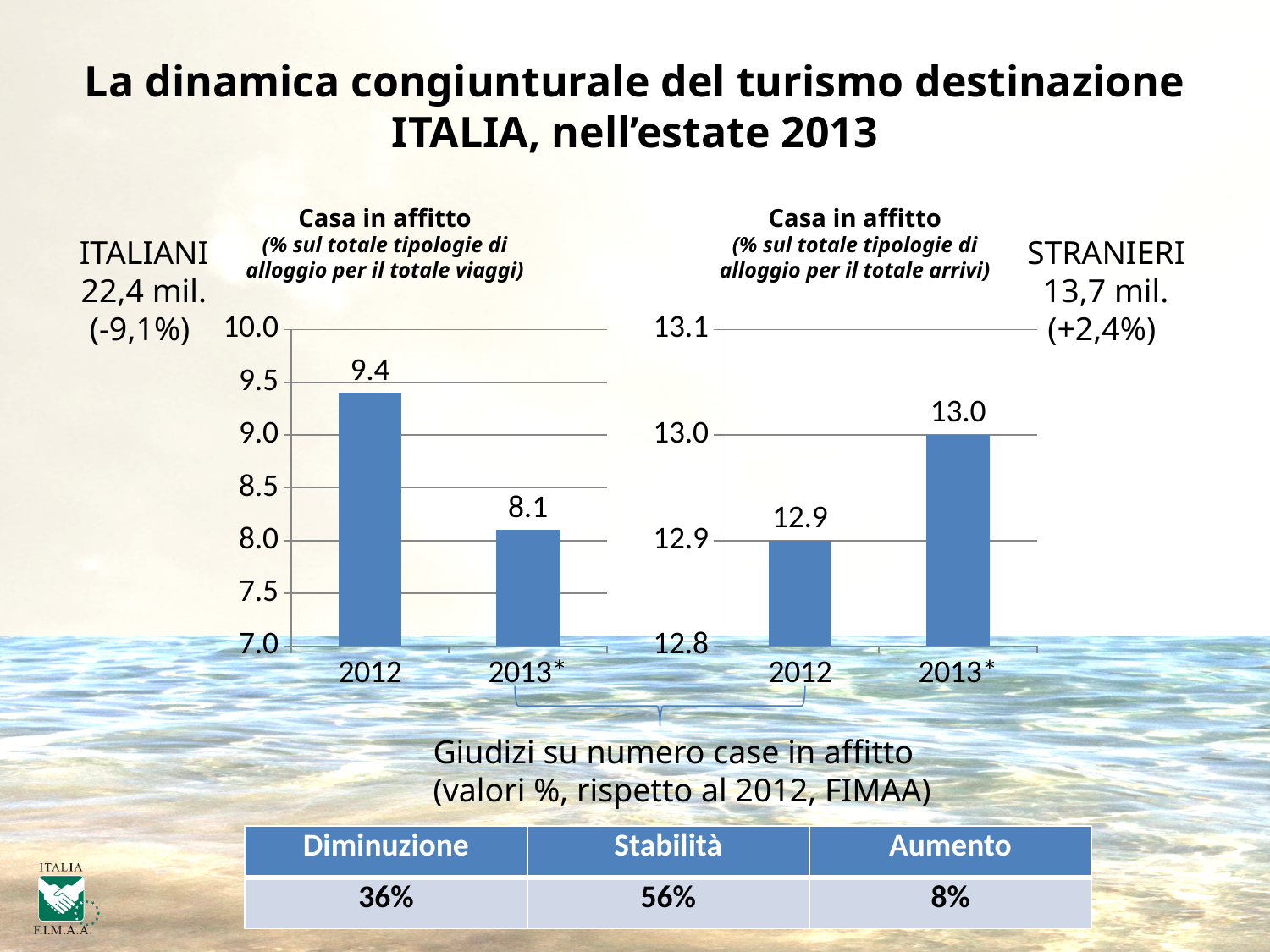
In the right chart (STRANIERI, Casa in affitto), what is the value for 2013*? 13.0 In the left chart (ITALIANI), do the values rise or fall from 2012 to 2013*? fall In the right chart (STRANIERI), do the values rise or fall from 2012 to 2013*? rise In the left chart (ITALIANI, Casa in affitto), what is the value for 2013*? 8.1 In the right chart (STRANIERI, Casa in affitto), what is the value for 2012? 12.9 In the right chart (STRANIERI), which year has the lower value? 2012 In the left chart (ITALIANI), which year has the higher value? 2012 What kind of chart is the left chart (ITALIANI, Casa in affitto)? bar chart In the left chart (ITALIANI, Casa in affitto), what is the value for 2012? 9.4 How many bars are plotted in the right chart (STRANIERI, Casa in affitto)? 2 In the left chart (ITALIANI), what is the difference between the 2012 and 2013* values? 1.3 In the right chart (STRANIERI), what is the difference between the 2013* and 2012 values? 0.1